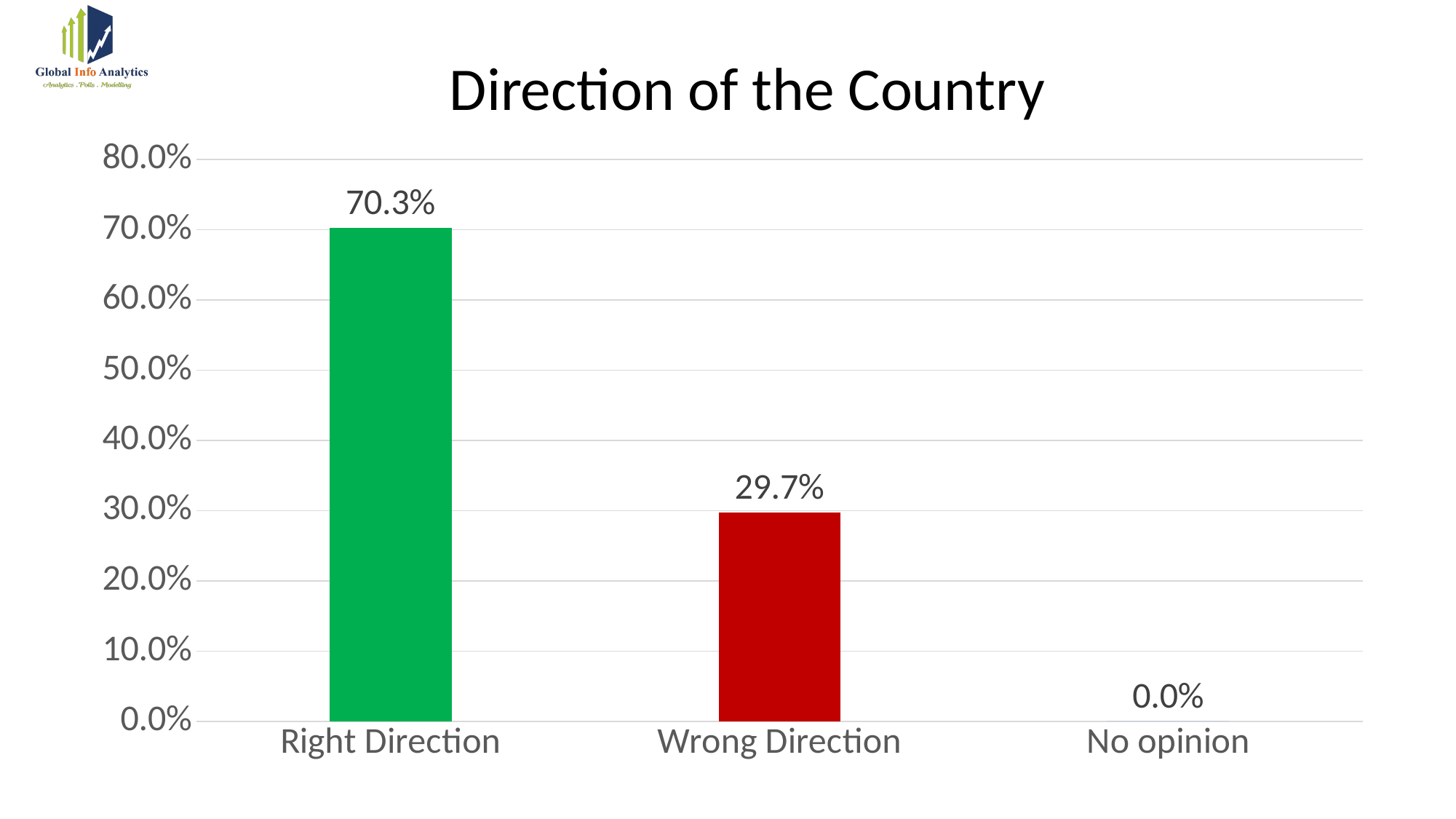
What colour is the bar for Wrong Direction? red Is the value for Wrong Direction greater or less than 40.0%? less What is the value for No opinion? 0.0% Which category has the highest value? Right Direction What is the value for Right Direction? 70.3% What is the title of the chart? Direction of the Country Which category has the lowest value? No opinion What kind of chart is shown on the slide? bar chart How many categories are shown on the x axis? 3 What is the difference between the values for Right Direction and Wrong Direction? 40.6% Which is larger, the value for Right Direction or the value for Wrong Direction? Right Direction What is the value for Wrong Direction? 29.7%